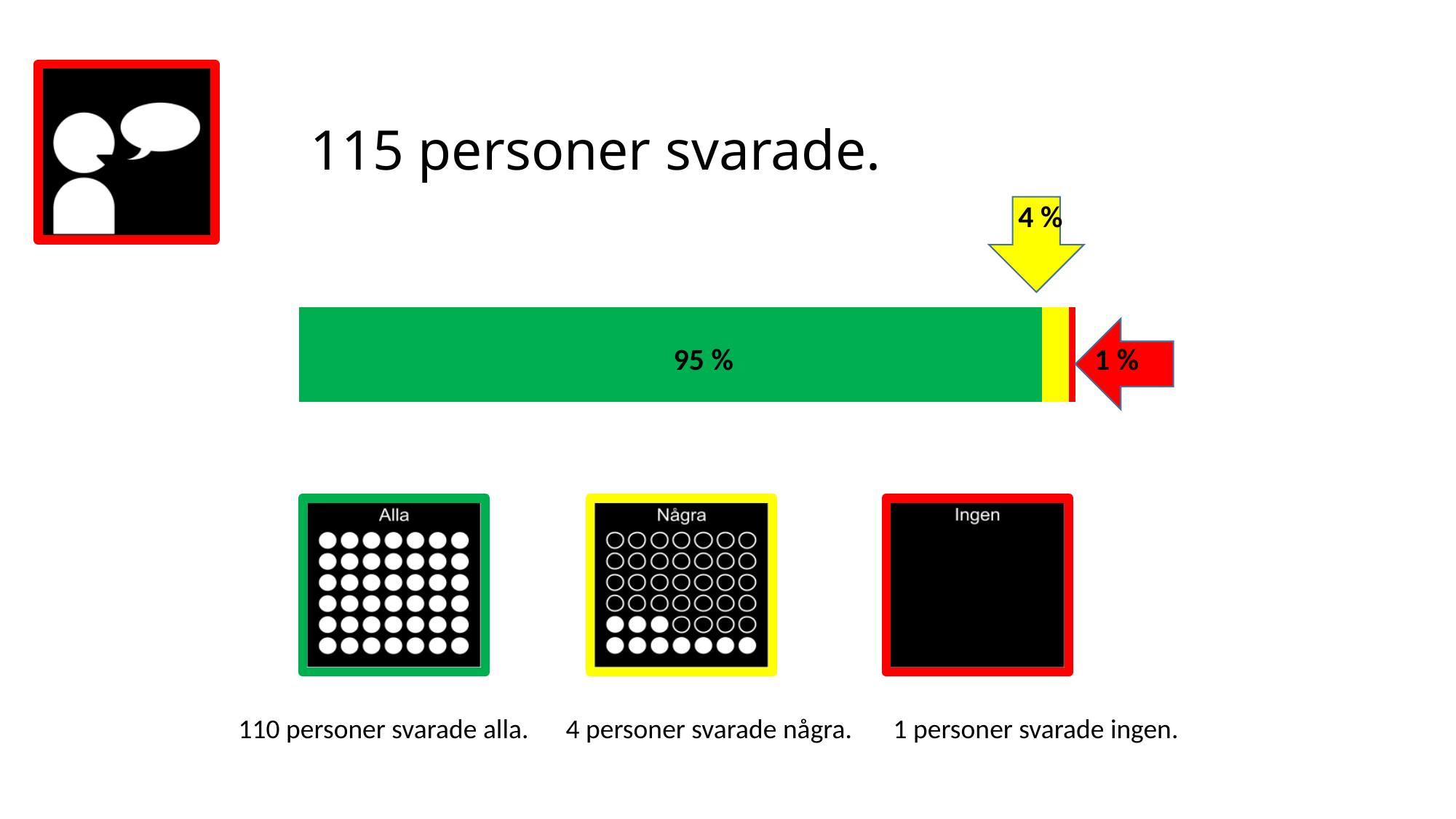
Which segment of the bar is the largest? 95 % (green, Alla) Which is larger, the yellow segment or the red segment of the bar? The yellow segment (4 %) What colour is the segment labelled 4 %? Yellow What kind of chart is shown on the slide? A stacked horizontal bar chart What is the total of the three segments of the bar? 100 % What is the difference between the green segment and the yellow segment of the bar? 91 % What percentage does the green segment of the bar show? 95 % Which segment of the bar is the smallest? 1 % (red, Ingen) How many people answered in total, according to the slide title? 115 How many segments does the stacked bar have? 3 What percentage does the yellow segment of the bar show? 4 % What percentage does the red segment of the bar show? 1 %